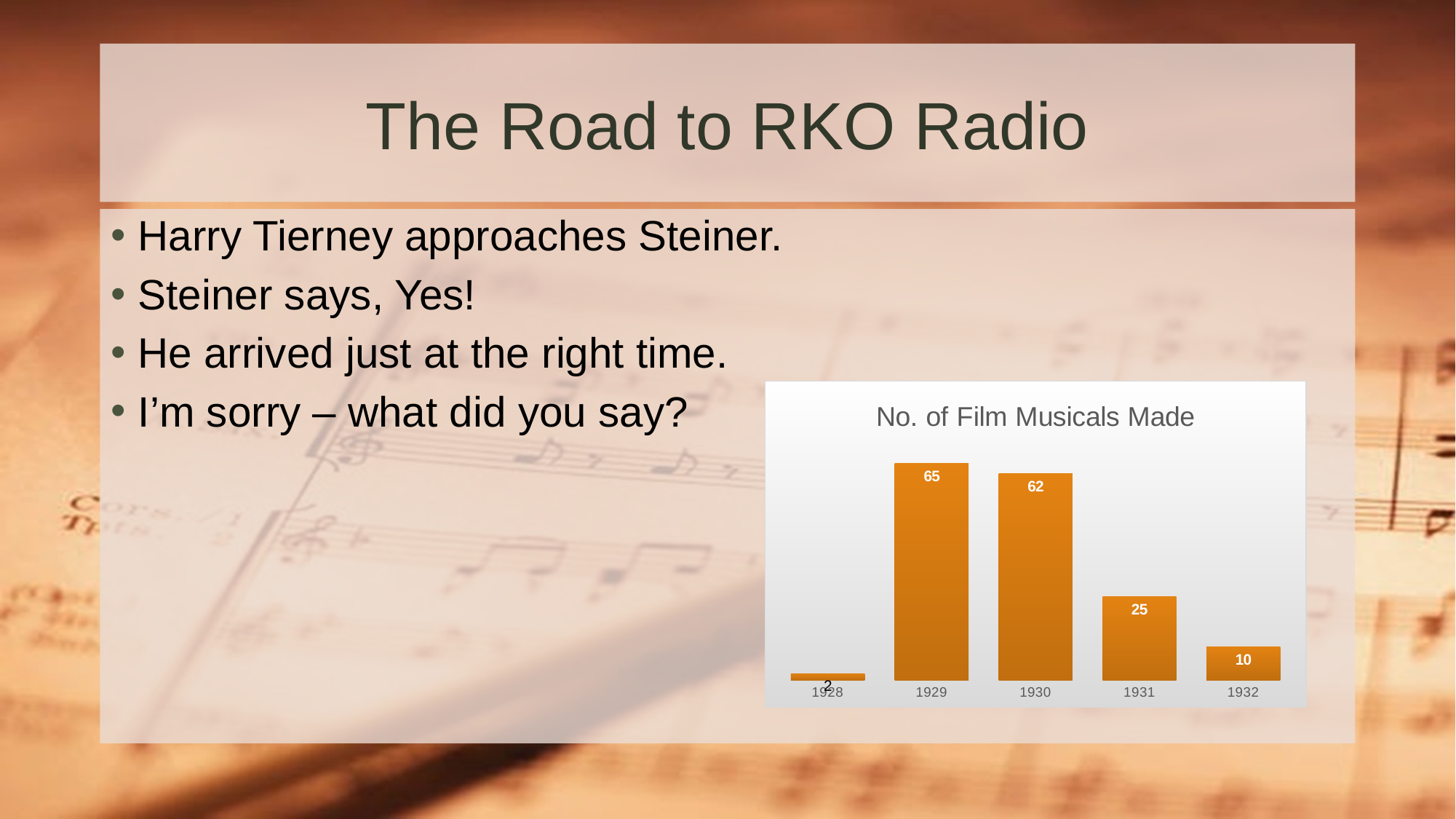
How many years are shown on the x axis of the chart? 5 Which year has the lowest number of film musicals made? 1928 Which is larger, the value for 1930 or the value for 1931? 1930 What kind of chart is shown on the slide? bar chart What is the value for 1931 in the chart? 25 Which year has the highest number of film musicals made? 1929 What is the value for 1932 in the chart? 10 What is the difference between the values for 1929 and 1930? 3 What is the title of the chart? No. of Film Musicals Made What is the value for 1929 in the chart? 65 What is the value for 1928 in the chart? 2 What is the difference between the values for 1931 and 1932? 15